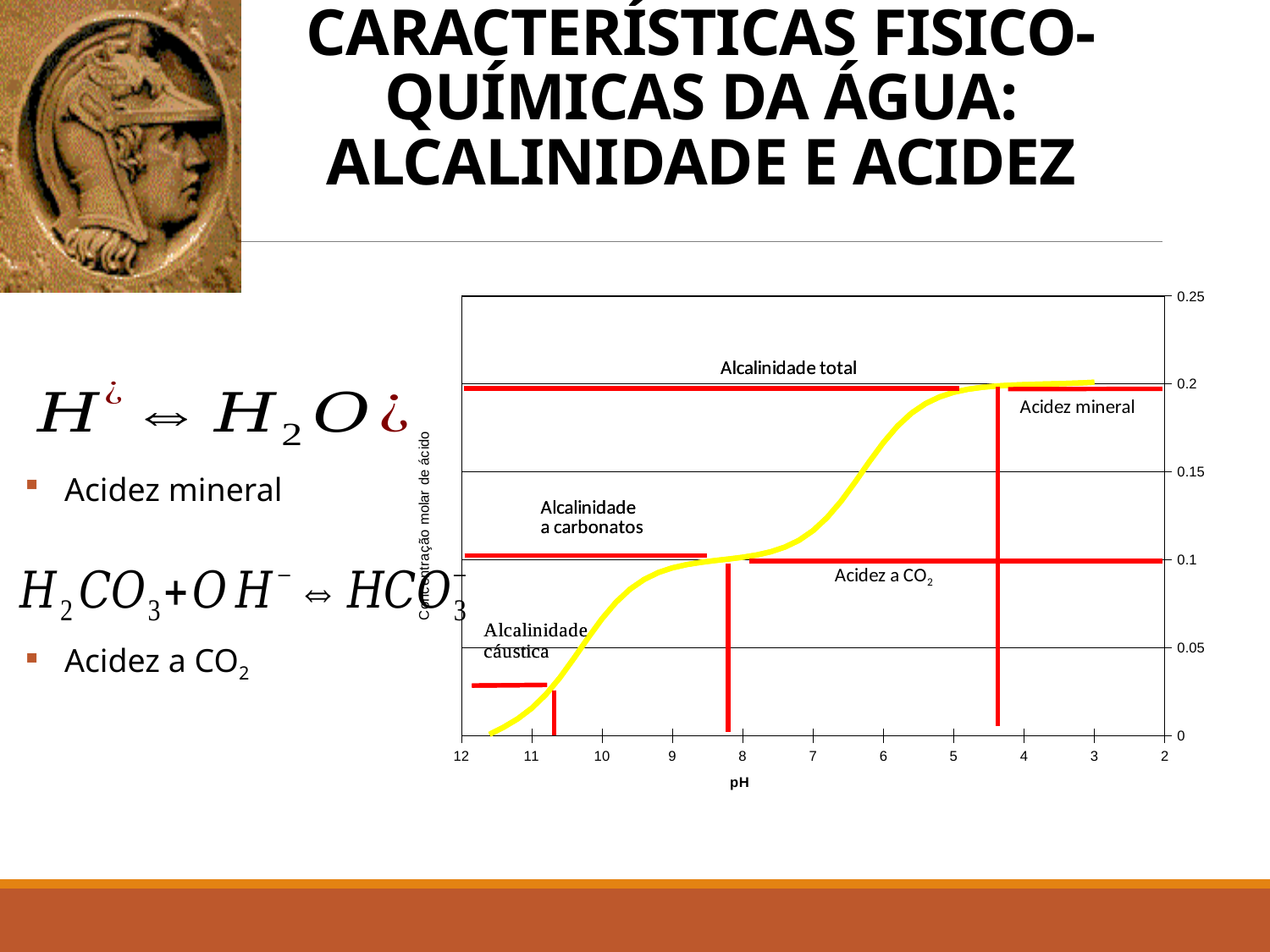
Which red line sits higher on the chart, 'Alcalinidade total' or 'Alcalinidade a carbonatos'? Alcalinidade total Is the value of the yellow curve at pH 10 greater or less than 0.1? less Is the value of the yellow curve at pH 6 greater or less than 0.1? greater How many labelled regions (alkalinity and acidity types) are annotated on the chart? 5 What is the label of the y axis of the chart? Concentração molar de ácido Is the yellow curve higher at pH 5 or at pH 9? pH 5 Does the yellow curve rise or fall from left to right across the chart? rise How many tick labels are shown on the pH axis? 11 Is the value of the yellow curve at pH 11 greater or less than 0.05? less What is the label of the x axis of the chart? pH What kind of chart is shown on the slide? line chart